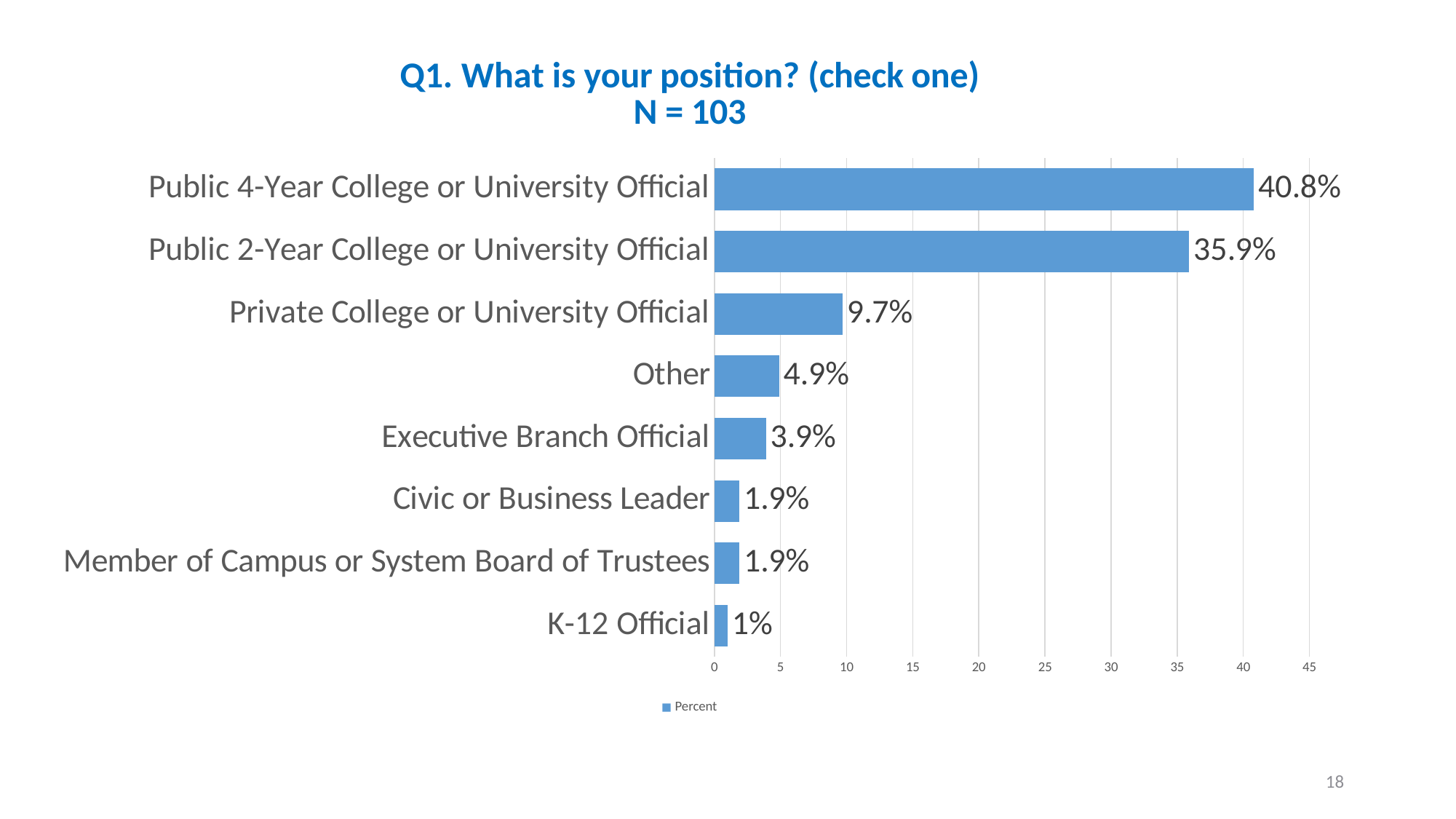
Which category has the highest value? Public 4-Year College or University Official Which category has the lowest value? K-12 Official How many categories are shown in the chart? 8 Which is larger, the value for Other or the value for Executive Branch Official? Other What is the legend entry for the series in the chart? Percent What is the value for Private College or University Official? 9.7% Is the value for Public 2-Year College or University Official greater or less than 30? greater How many series does the legend list? 1 What kind of chart is shown on the slide? bar chart What is the value for Executive Branch Official? 3.9% What is the value for Public 4-Year College or University Official? 40.8% What is the difference between the values for Public 4-Year College or University Official and Public 2-Year College or University Official? 4.9%